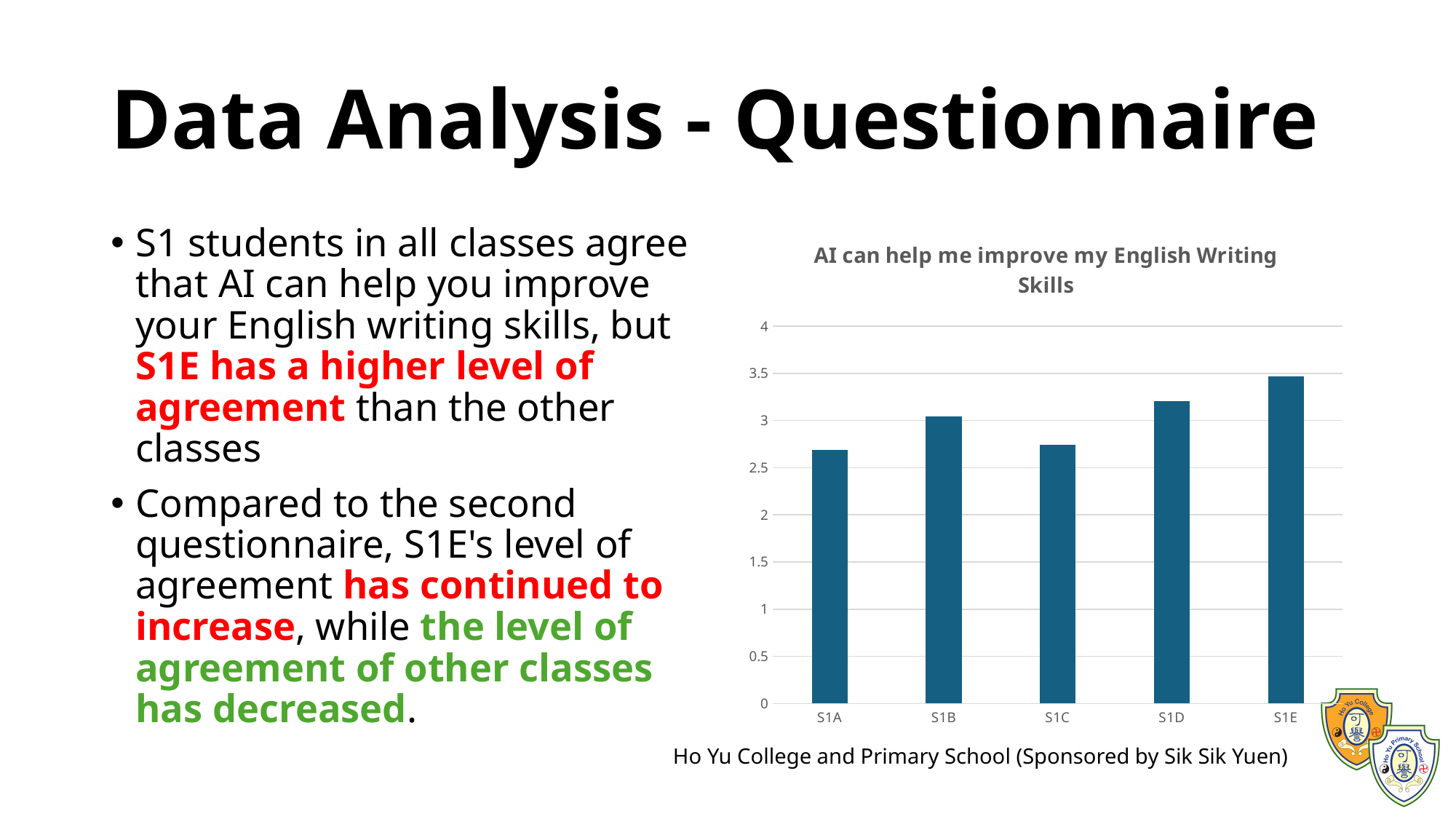
Which is larger, the value for S1B or the value for S1A? S1B Which class has the highest value in the chart? S1E Is the value for S1E greater or less than 3? greater What is the title of the chart? AI can help me improve my English Writing Skills Is the value for S1D greater or less than 3? greater Is the value for S1A greater or less than 3? less Which is larger, the value for S1E or the value for S1D? S1E How many classes are shown on the x axis of the chart? 5 What kind of chart is shown on the slide? bar chart Which is larger, the value for S1D or the value for S1B? S1D